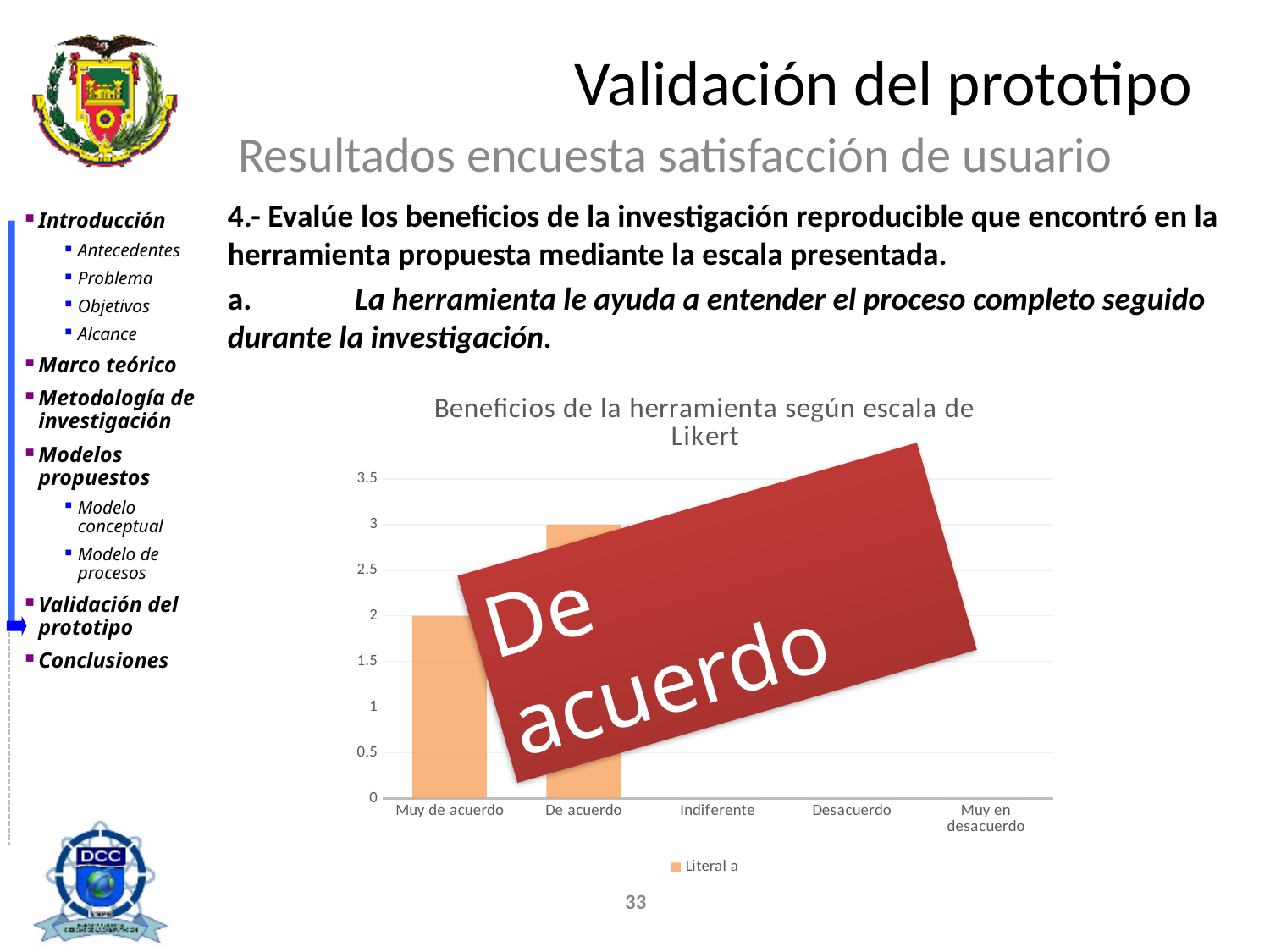
What is the name of the series shown in the chart legend? Literal a What is the difference between the values for "De acuerdo" and "Muy de acuerdo"? 1 How many categories are shown on the x axis of the chart? 5 What is the title of the chart? Beneficios de la herramienta según escala de Likert What is the value for "Muy de acuerdo" in the chart? 2 Is the value for "De acuerdo" greater or less than 2.5? greater Which category has the highest value in the chart? De acuerdo Is the value for "Muy de acuerdo" greater or less than 2.5? less How many series does the chart legend list? 1 What kind of chart is shown on the slide? Bar chart What is the value for "De acuerdo" in the chart? 3 Which is larger, the value for "Muy de acuerdo" or the value for "De acuerdo"? De acuerdo